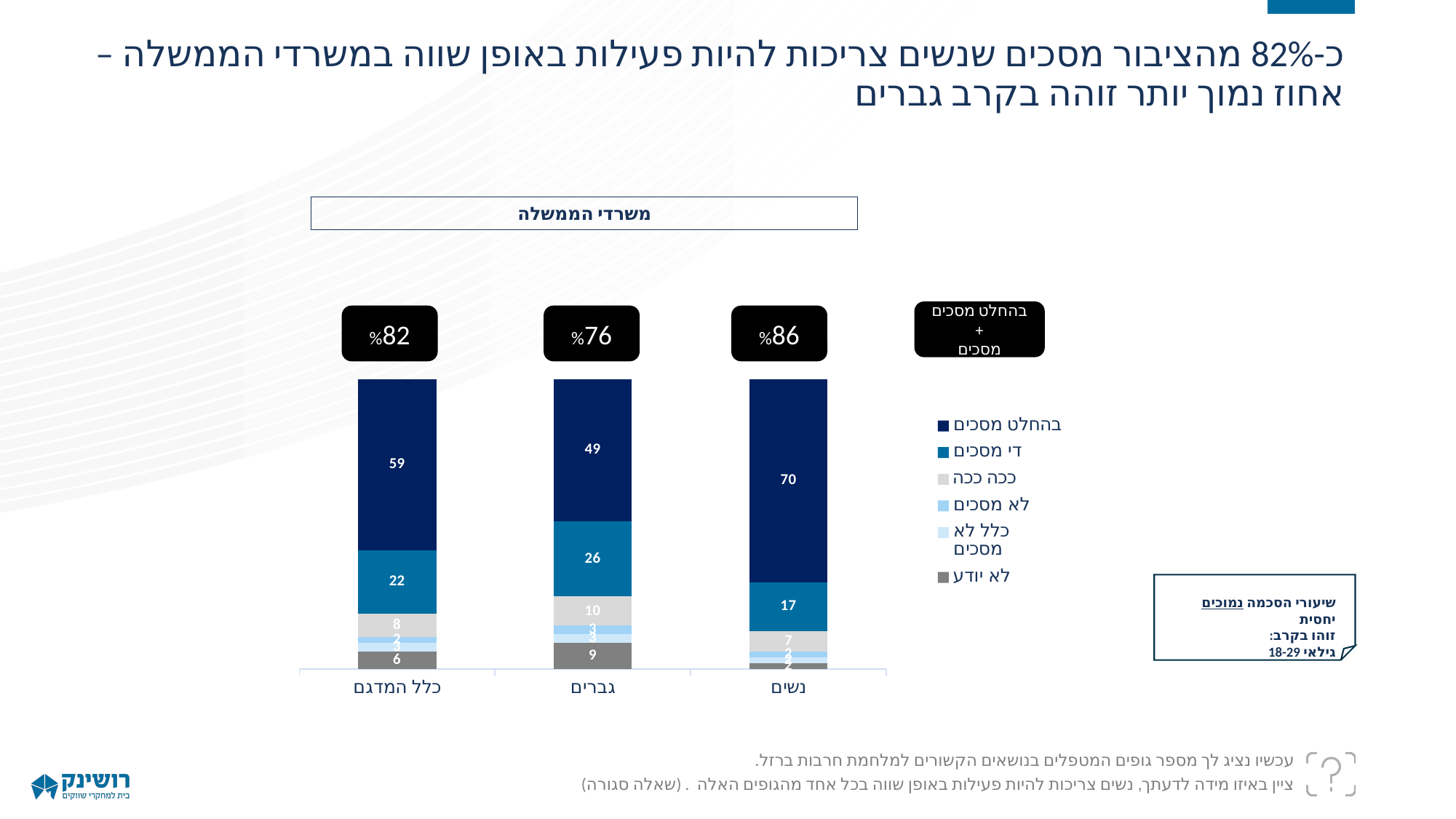
What kind of chart is shown on the slide? stacked bar chart What is the value of בהחלט מסכים for גברים? 49 Which category has the highest value for בהחלט מסכים? נשים What is the value of בהחלט מסכים for נשים? 70 Which is larger, the די מסכים value for גברים or for נשים? גברים What is the title shown above the chart? משרדי הממשלה What is the difference between the בהחלט מסכים values for נשים and גברים? 21 How many categories are shown on the x axis of the chart? 3 What is the value of די מסכים for כלל המדגם? 22 Which category has the lowest value for בהחלט מסכים? גברים What combined percentage (בהחלט מסכים + מסכים) is shown in the black box above the גברים bar? %76 How many series does the legend list? 6